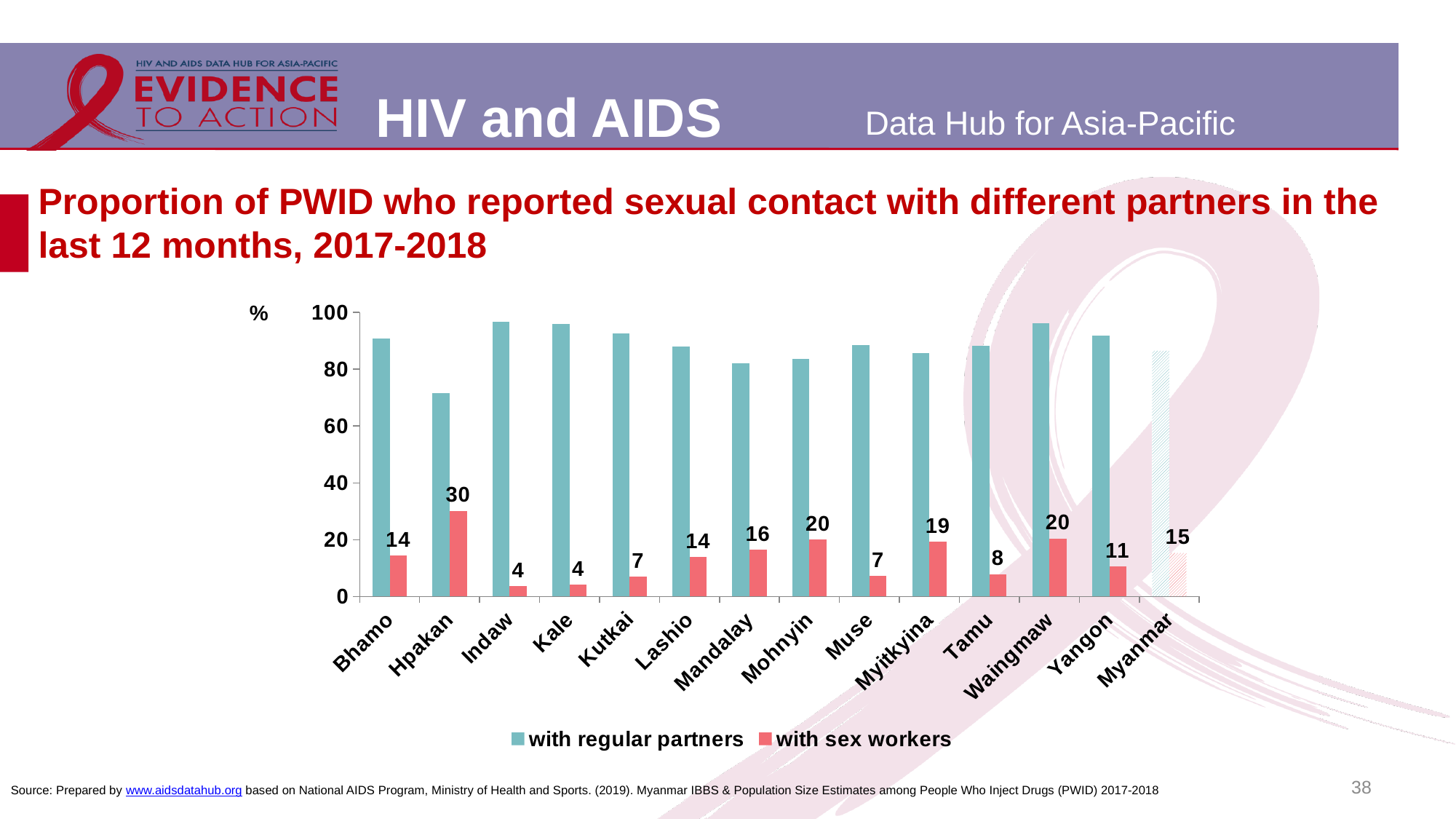
How many series does the legend list? 2 Which has a higher 'with sex workers' value, Mohnyin or Muse? Mohnyin What is the difference between the 'with sex workers' values for Hpakan and Yangon? 19 Which location has the highest proportion of PWID reporting sexual contact with sex workers? Hpakan Is the 'with regular partners' value for Hpakan greater or less than 80? less Is the 'with regular partners' value for Indaw greater or less than 80? greater What type of chart is shown on the slide? bar chart What colour are the bars for 'with sex workers'? red What is the proportion of PWID in Hpakan who reported sexual contact with sex workers? 30 How many locations (categories) are shown along the x axis? 14 What is the value for 'with sex workers' in Mohnyin? 20 What is the value for 'with sex workers' for Myanmar overall? 15